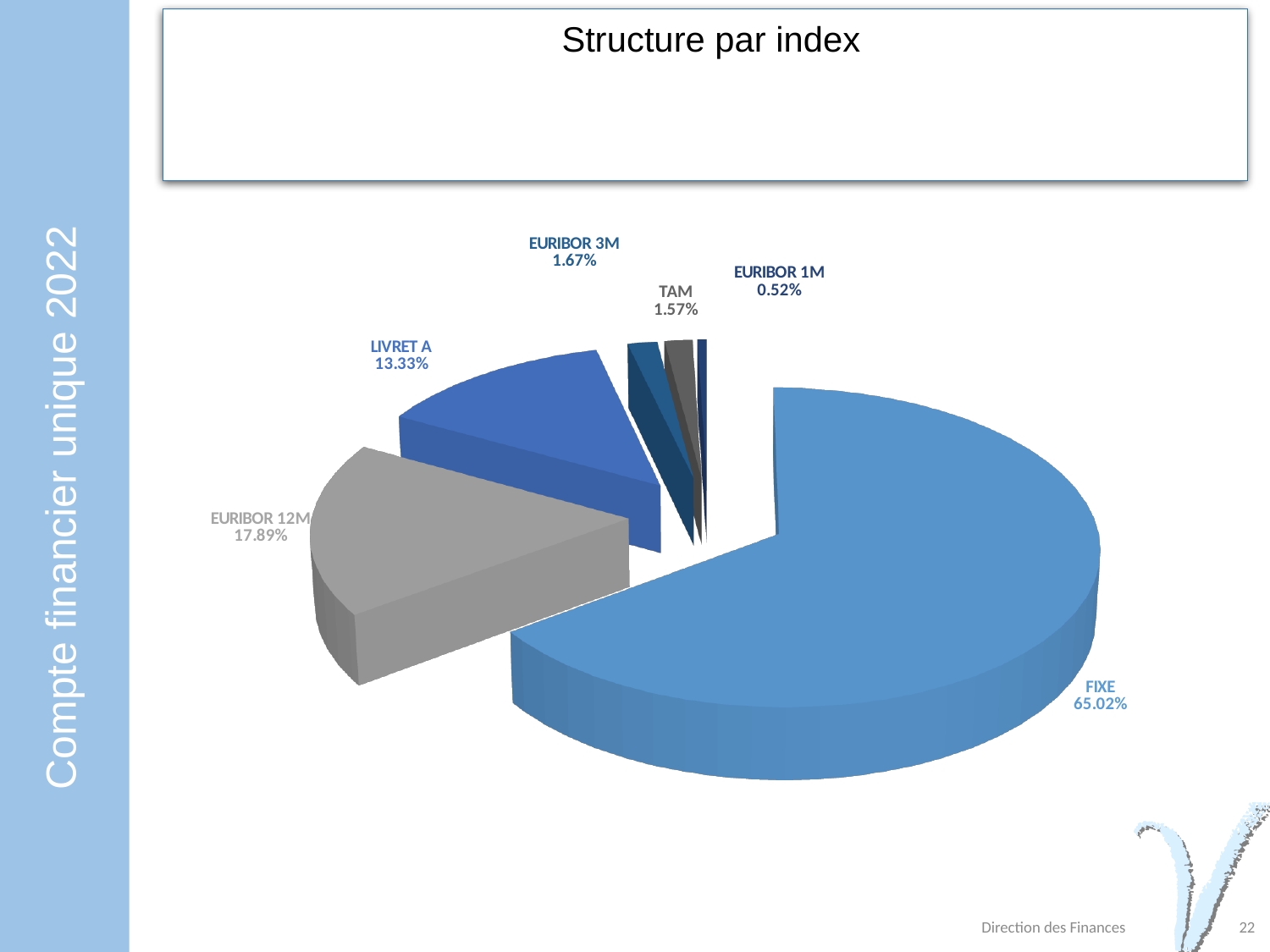
What is the title of the chart on the slide? Structure par index What share does EURIBOR 12M have in the pie chart? 17.89% What type of chart is shown on the slide? Pie chart Which is larger, the share of EURIBOR 12M or the share of LIVRET A? EURIBOR 12M What share does TAM have in the pie chart? 1.57% Which category has the smallest share in the pie chart? EURIBOR 1M What share does EURIBOR 1M have in the pie chart? 0.52% What share does LIVRET A have in the pie chart? 13.33% What is the difference between the shares of EURIBOR 3M and TAM? 0.10% What share does FIXE have in the pie chart? 65.02% How many slices does the pie chart have? 6 Which category has the largest share in the pie chart? FIXE